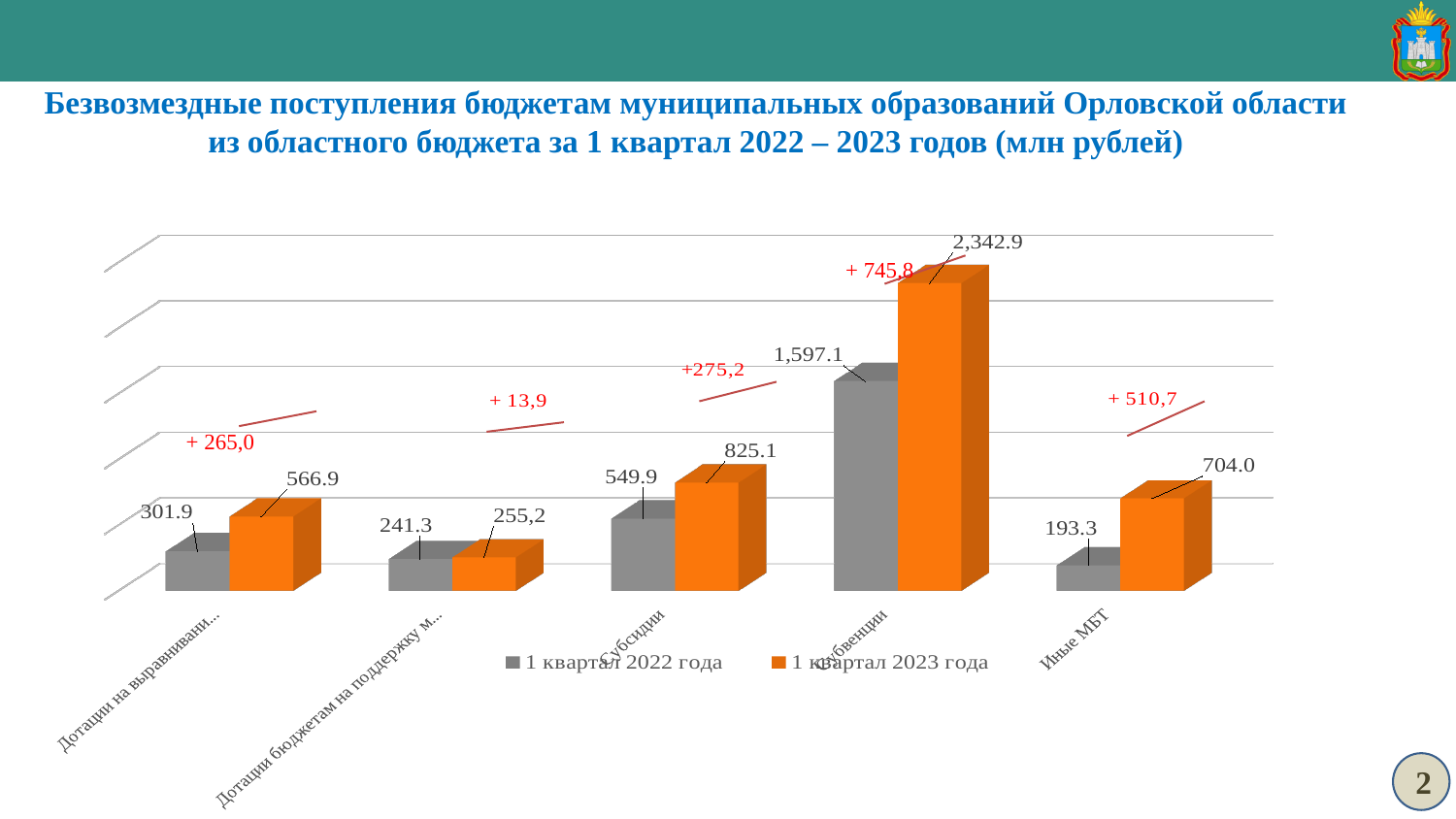
What is the difference between the 1 квартал 2023 года and 1 квартал 2022 года values for Иные МБТ? 510.7 How many categories are shown on the x axis? 5 Which category has the highest value for 1 квартал 2023 года? Субвенции How many series does the legend list? 2 What is the difference between the 1 квартал 2023 года and 1 квартал 2022 года values for Субсидии? 275.2 Which is larger for 1 квартал 2023 года: Субсидии or Иные МБТ? Субсидии What is the value for Субсидии in 1 квартал 2022 года? 549.9 What is the value for Иные МБТ in 1 квартал 2022 года? 193.3 What kind of chart is shown on the slide? bar chart What is the value for Субсидии in 1 квартал 2023 года? 825.1 Which category has the lowest value for 1 квартал 2022 года? Иные МБТ What is the value for Иные МБТ in 1 квартал 2023 года? 704.0